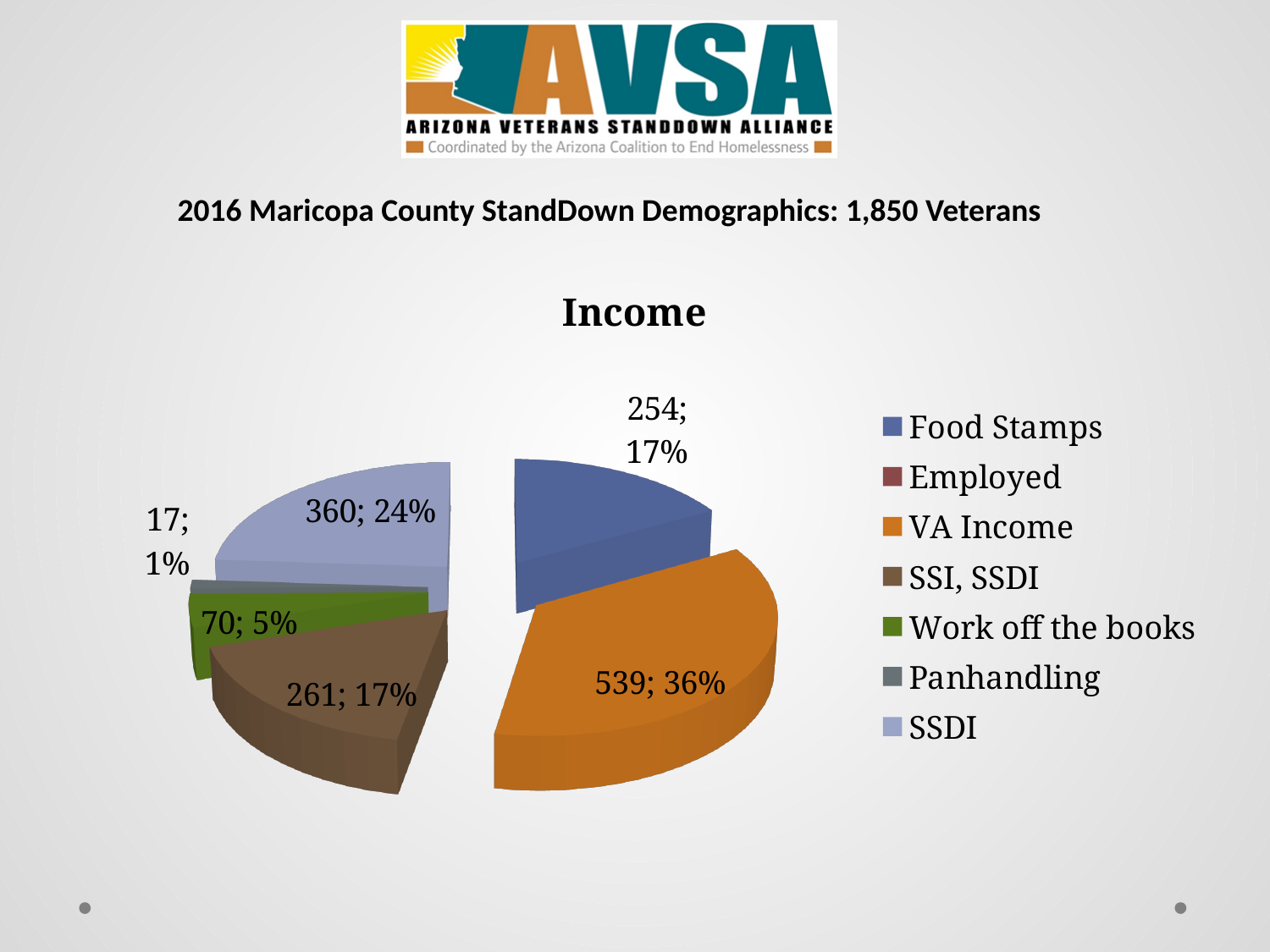
How many categories does the chart's legend list? 7 What is the value shown for SSDI? 360 Which is larger, the value for SSDI or the value for Food Stamps? SSDI What is the title of the chart? Income What is the value shown for Work off the books? 70 What is the value shown for Food Stamps? 254 What is the value shown for VA Income? 539 What type of chart is shown on the slide? pie chart What percentage share of the pie does VA Income represent? 36% What is the difference between the VA Income value and the SSDI value? 179 What percentage share of the pie does SSDI represent? 24% Which category has the largest slice of the pie? VA Income